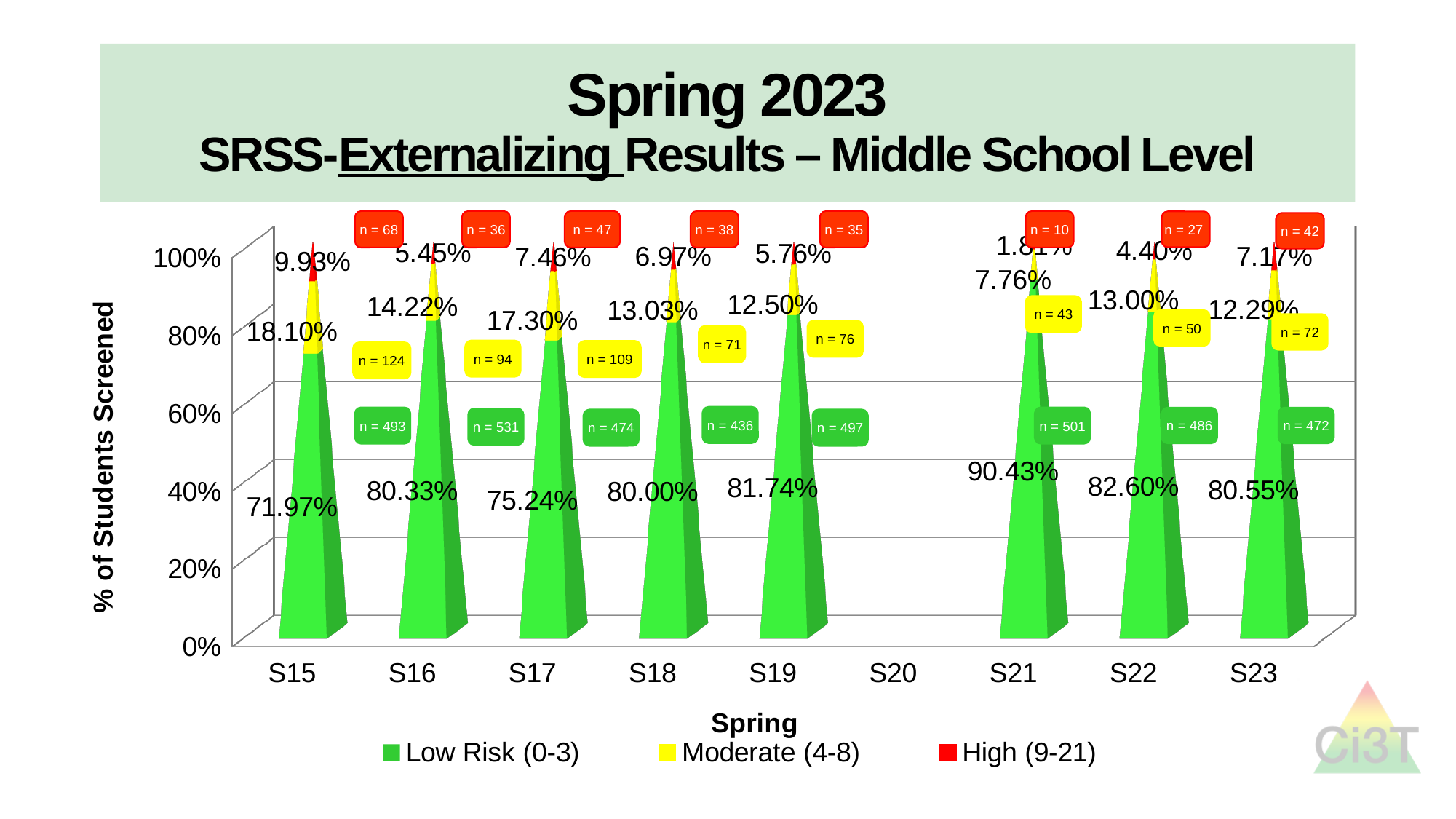
What is the High (9-21) percentage for S23? 7.17% What kind of chart is shown on the slide? Stacked bar chart What is the difference between the Low Risk (0-3) percentages for S21 and S15? 18.46% What is the Moderate (4-8) percentage for S17? 17.30% What is the total of the stacked bar for S22? 100% What is the label of the x axis? Spring Which spring has the highest Low Risk (0-3) percentage? S21 How many series does the legend list? 3 Is the Low Risk (0-3) value for S19 greater or less than 80%? greater What is the Low Risk (0-3) percentage for S15? 71.97% Which is larger, the Moderate (4-8) percentage for S16 or for S18? S16 Which spring has the lowest High (9-21) percentage? S21